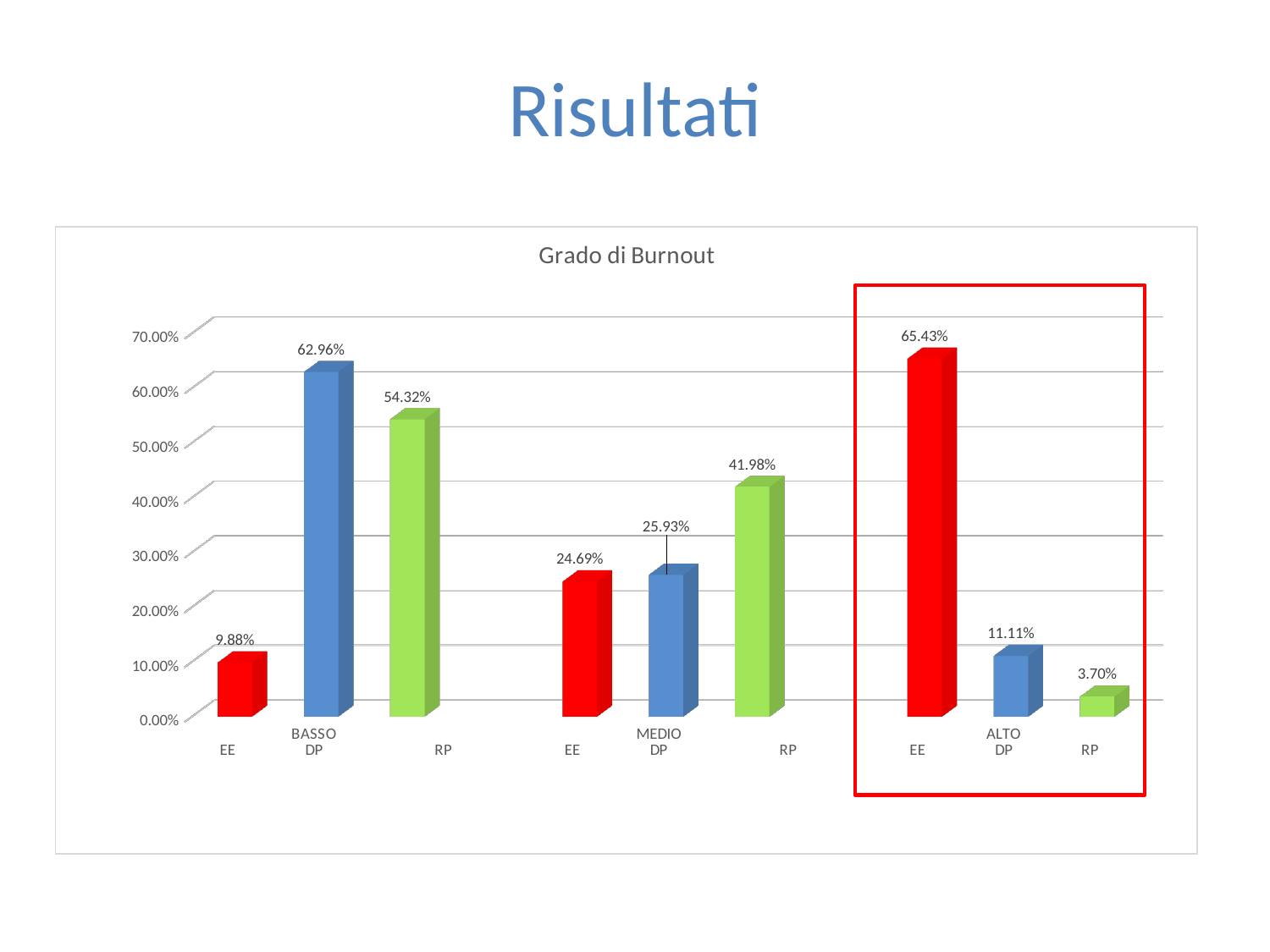
What is the value for EE in the BASSO group? 9.88% What is the difference between EE in the ALTO group and EE in the BASSO group? 55.55% What is the value for DP in the ALTO group? 11.11% Which is larger in the MEDIO group, EE or RP? RP What is the difference between DP and RP in the BASSO group? 8.64% Which bar has the highest value in the chart? EE in the ALTO group (65.43%) What is the title of the chart? Grado di Burnout What is the value for RP in the MEDIO group? 41.98% What kind of chart is shown on the slide? Bar chart Which bar has the lowest value in the chart? RP in the ALTO group (3.70%) Is the value for DP in the BASSO group greater or less than 60.00%? greater How many bars are plotted in the chart? 9